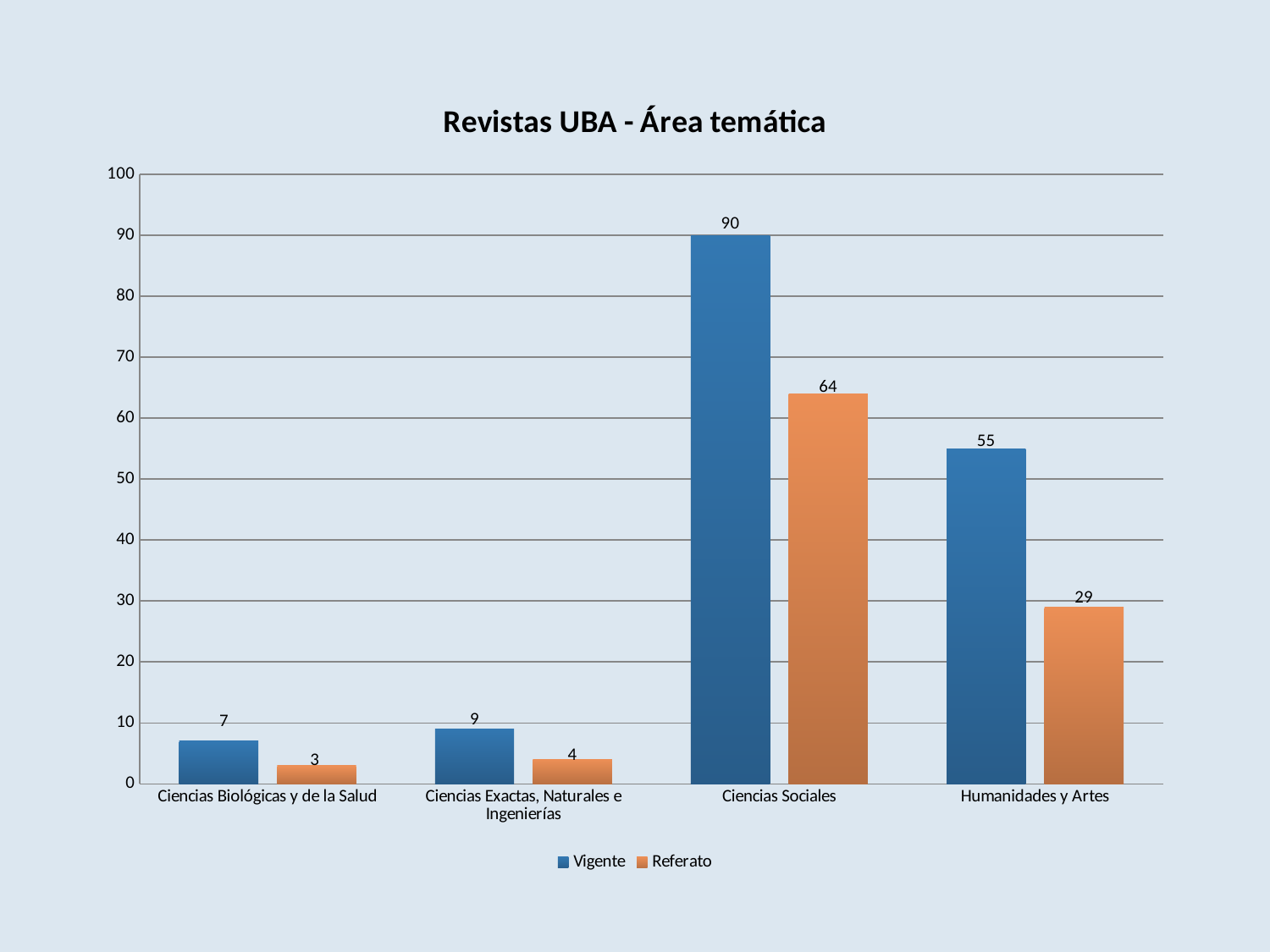
What kind of chart is shown on the slide? Bar chart What is the difference between the Vigente values for Humanidades y Artes and Ciencias Exactas, Naturales e Ingenierías? 46 What is the difference between the Vigente and Referato values for Ciencias Sociales? 26 How many categories are shown on the x axis? 4 What is the title of the chart? Revistas UBA - Área temática Which category has the lowest Referato value? Ciencias Biológicas y de la Salud What is the Referato value for Ciencias Biológicas y de la Salud? 3 Which category has the highest Vigente value? Ciencias Sociales Which is larger, the Vigente value for Ciencias Exactas, Naturales e Ingenierías or the Vigente value for Ciencias Biológicas y de la Salud? Ciencias Exactas, Naturales e Ingenierías What is the Vigente value for Ciencias Sociales? 90 What is the Referato value for Humanidades y Artes? 29 How many series does the legend list? 2